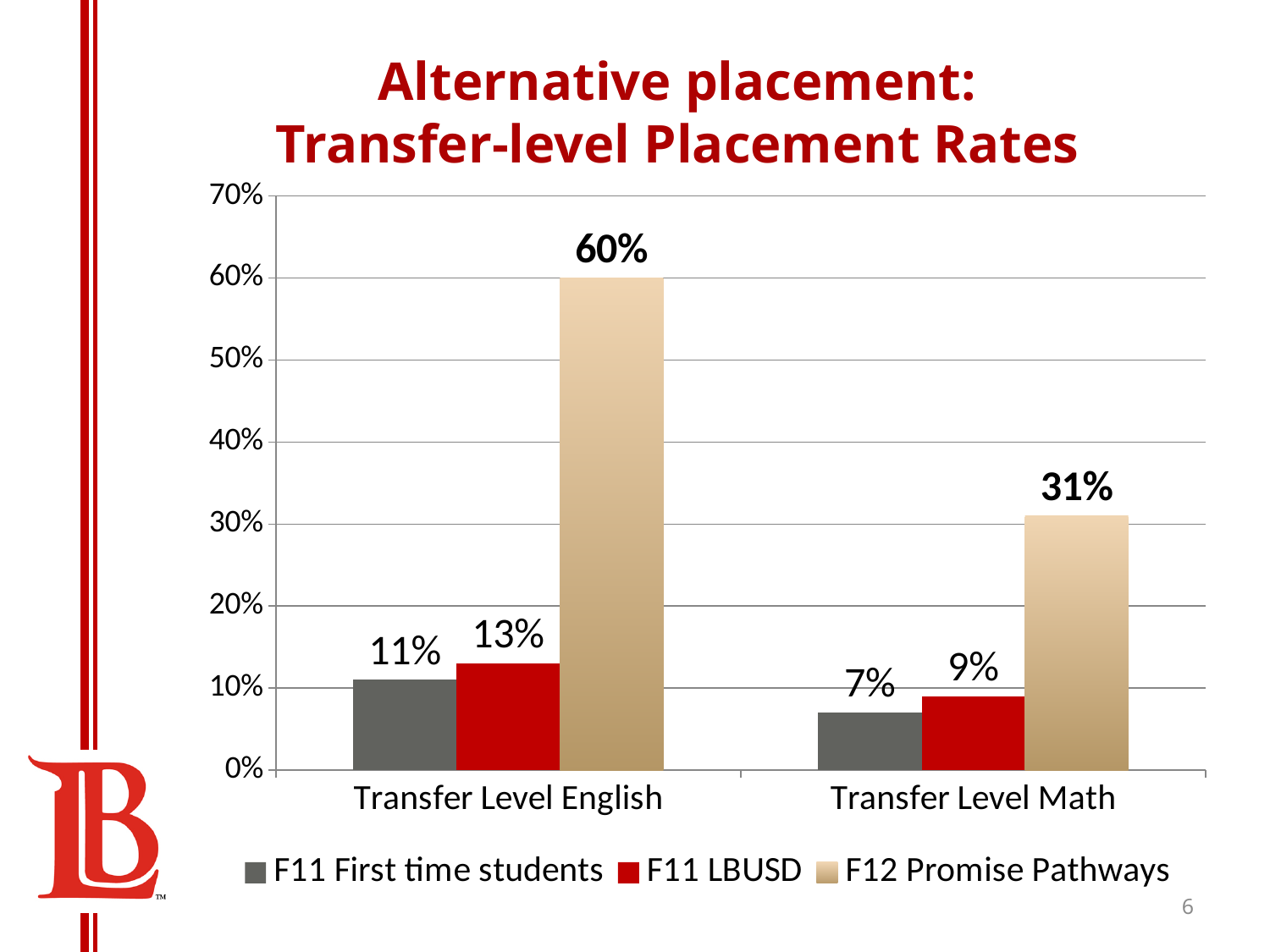
Which series has the lowest value for Transfer Level English? F11 First time students Is the F12 Promise Pathways value for Transfer Level Math greater or less than 40%? less How many categories are shown on the x axis? 2 What is the F12 Promise Pathways value for Transfer Level English? 60% What is the F11 First time students value for Transfer Level English? 11% What is the difference between the F12 Promise Pathways values for Transfer Level English and Transfer Level Math? 29% Which is larger: the F11 LBUSD value for Transfer Level English or the F11 LBUSD value for Transfer Level Math? Transfer Level English Which series has the highest value for Transfer Level Math? F12 Promise Pathways How many series does the legend list? 3 What kind of chart is shown on the slide? Bar chart What is the F11 LBUSD value for Transfer Level Math? 9% What is the title of the chart? Alternative placement: Transfer-level Placement Rates